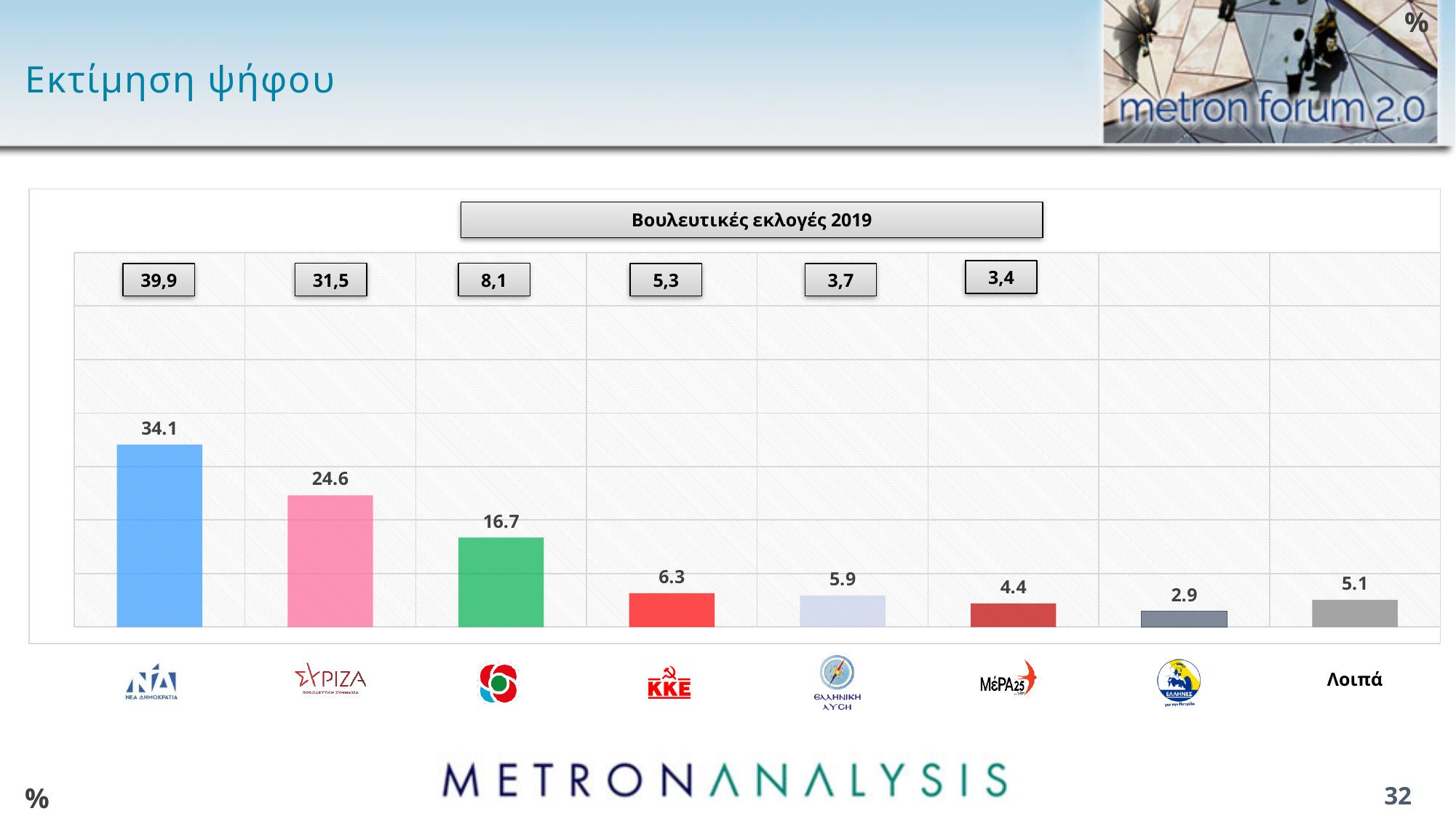
What is the vote estimate value shown for ΝΕΑ ΔΗΜΟΚΡΑΤΙΑ (the first bar)? 34.1 What value is shown in the 'Βουλευτικές εκλογές 2019' box above the ΣΥΡΙΖΑ bar? 31,5 What is the difference between the vote estimates for ΝΕΑ ΔΗΜΟΚΡΑΤΙΑ and ΣΥΡΙΖΑ? 9.5 Which has the larger vote estimate, ΚΚΕ or ΕΛΛΗΝΙΚΗ ΛΥΣΗ? ΚΚΕ Which party has the highest vote estimate in the chart? ΝΕΑ ΔΗΜΟΚΡΑΤΙΑ What is the vote estimate value shown for ΣΥΡΙΖΑ? 24.6 What is the title of the slide? Εκτίμηση ψήφου What is the vote estimate value shown for Λοιπά? 5.1 How many bars are plotted in the chart? 8 What kind of chart is shown on the slide? Bar chart What is the vote estimate value shown for ΚΚΕ? 6.3 Which party has the lowest vote estimate in the chart? ΕΛΛΗΝΕΣ (2.9)